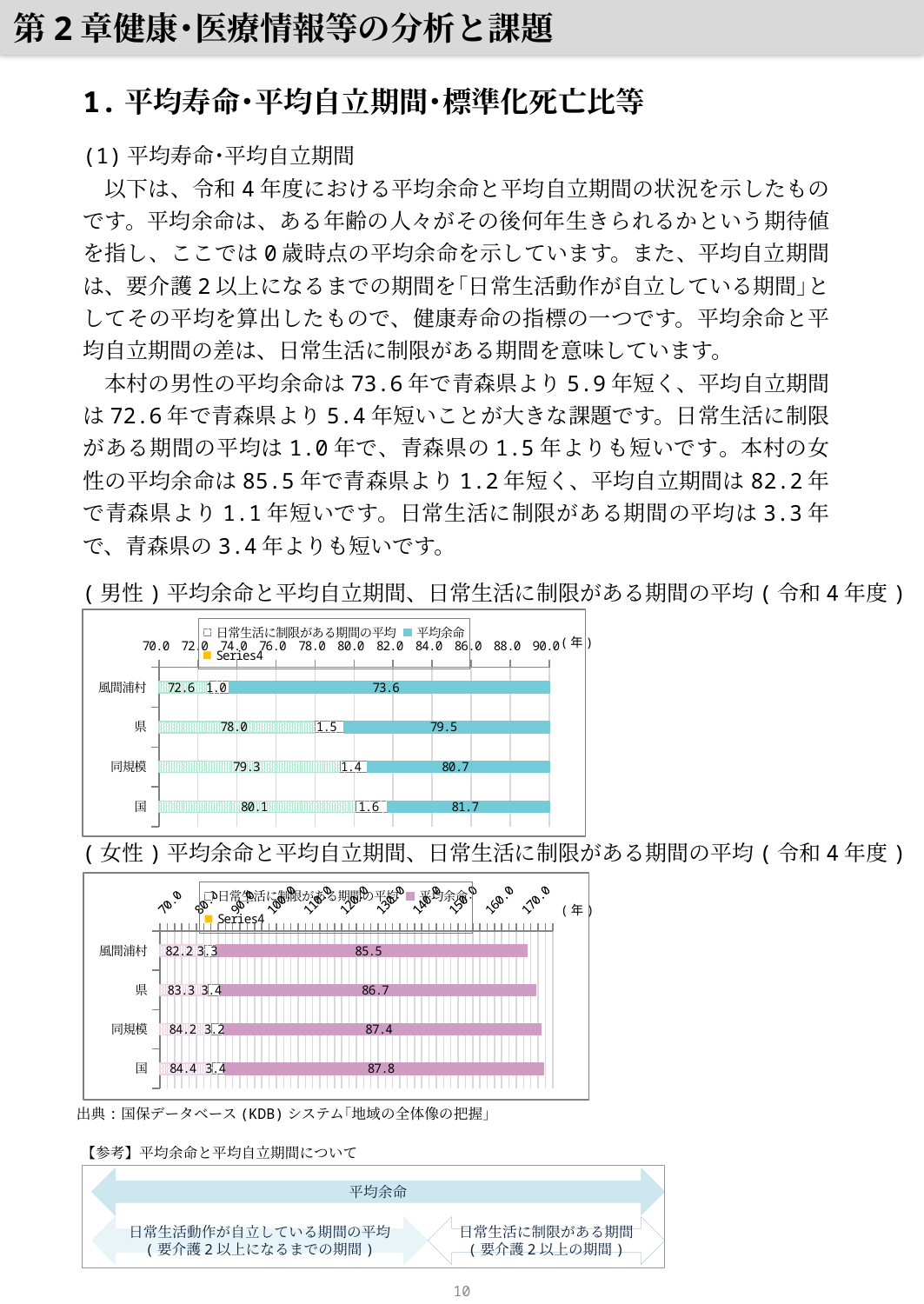
In the female chart (女性), what is the 平均余命 value for 国? 87.8 How many categories are shown on the y axis of the male chart (男性)? 4 In the female chart (女性), which category has the lowest 平均余命? 風間浦村 What kind of chart is the female chart (女性)? bar chart In the male chart (男性), which is larger, the 平均余命 of 県 or of 同規模? 同規模 In the male chart (男性), what is the 日常生活に制限がある期間の平均 value for 県? 1.5 In the female chart (女性), what is the difference between the 平均余命 of 県 and 風間浦村? 1.2 In the male chart (男性), which category has the highest 平均余命? 国 In the male chart (男性), what is the difference between the 平均余命 of 国 and 風間浦村? 8.1 In the female chart (女性), what is the leftmost (平均自立期間) value shown for 風間浦村? 82.2 In the male chart (男性), what is the 平均余命 value for 風間浦村? 73.6 What unit is shown at the end of the x axis of the male chart (男性)? 年